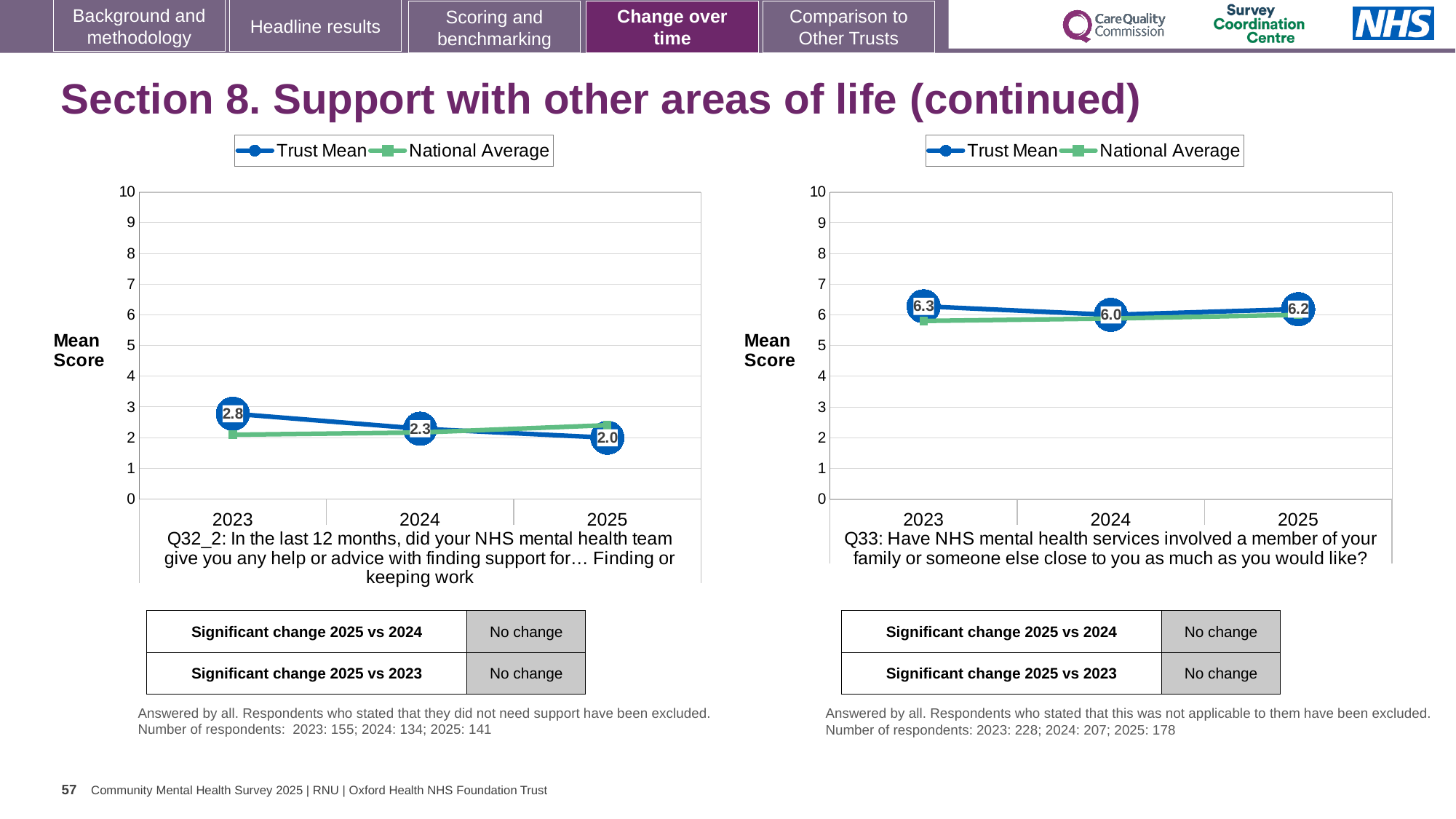
On the right chart (Q33), what is the Trust Mean for 2023? 6.3 What kind of chart is the right chart (Q33)? line chart On the right chart (Q33), what is the Trust Mean for 2024? 6.0 On the left chart (Q32_2), does the Trust Mean rise or fall from 2023 to 2025? fall On the left chart (Q32_2), what is the difference between the Trust Mean in 2023 and in 2025? 0.8 On the right chart (Q33), is the National Average for 2023 greater or less than 5? greater On the right chart (Q33), which year has the lowest Trust Mean? 2024 On the left chart (Q32_2), which year has the highest Trust Mean? 2023 On the left chart (Q32_2), what is the Trust Mean for 2025? 2.0 On the right chart (Q33), is the Trust Mean for 2025 larger or smaller than the Trust Mean for 2023? smaller On the left chart (Q32_2), what is the Trust Mean for 2023? 2.8 How many series does the legend of the left chart (Q32_2) list? 2